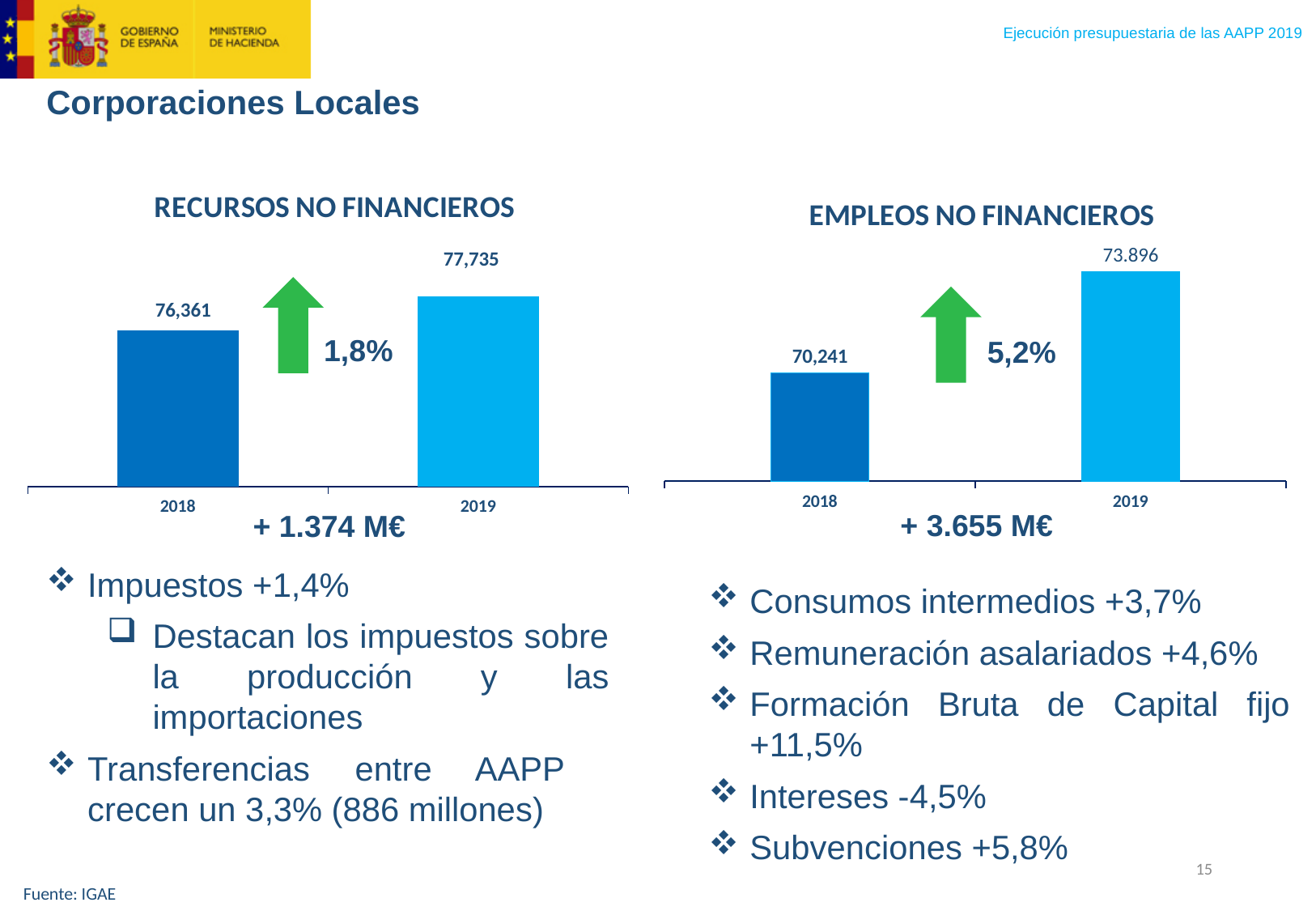
In the EMPLEOS NO FINANCIEROS chart, what is the value for 2019? 73.896 In the EMPLEOS NO FINANCIEROS chart, what is the difference between the 2019 and 2018 values? 3,655 What percentage change is shown next to the green arrow in the EMPLEOS NO FINANCIEROS chart? 5,2% In the RECURSOS NO FINANCIEROS chart, what is the value for 2019? 77,735 In the RECURSOS NO FINANCIEROS chart, what is the value for 2018? 76,361 What type of chart is the RECURSOS NO FINANCIEROS chart? bar chart In the EMPLEOS NO FINANCIEROS chart, is the value for 2019 larger or smaller than the value for 2018? larger In the EMPLEOS NO FINANCIEROS chart, which year has the lower value? 2018 In the RECURSOS NO FINANCIEROS chart, what is the difference between the 2019 and 2018 values? 1,374 In the RECURSOS NO FINANCIEROS chart, which year has the higher value? 2019 In the EMPLEOS NO FINANCIEROS chart, what is the value for 2018? 70,241 How many bars are shown in the EMPLEOS NO FINANCIEROS chart? 2